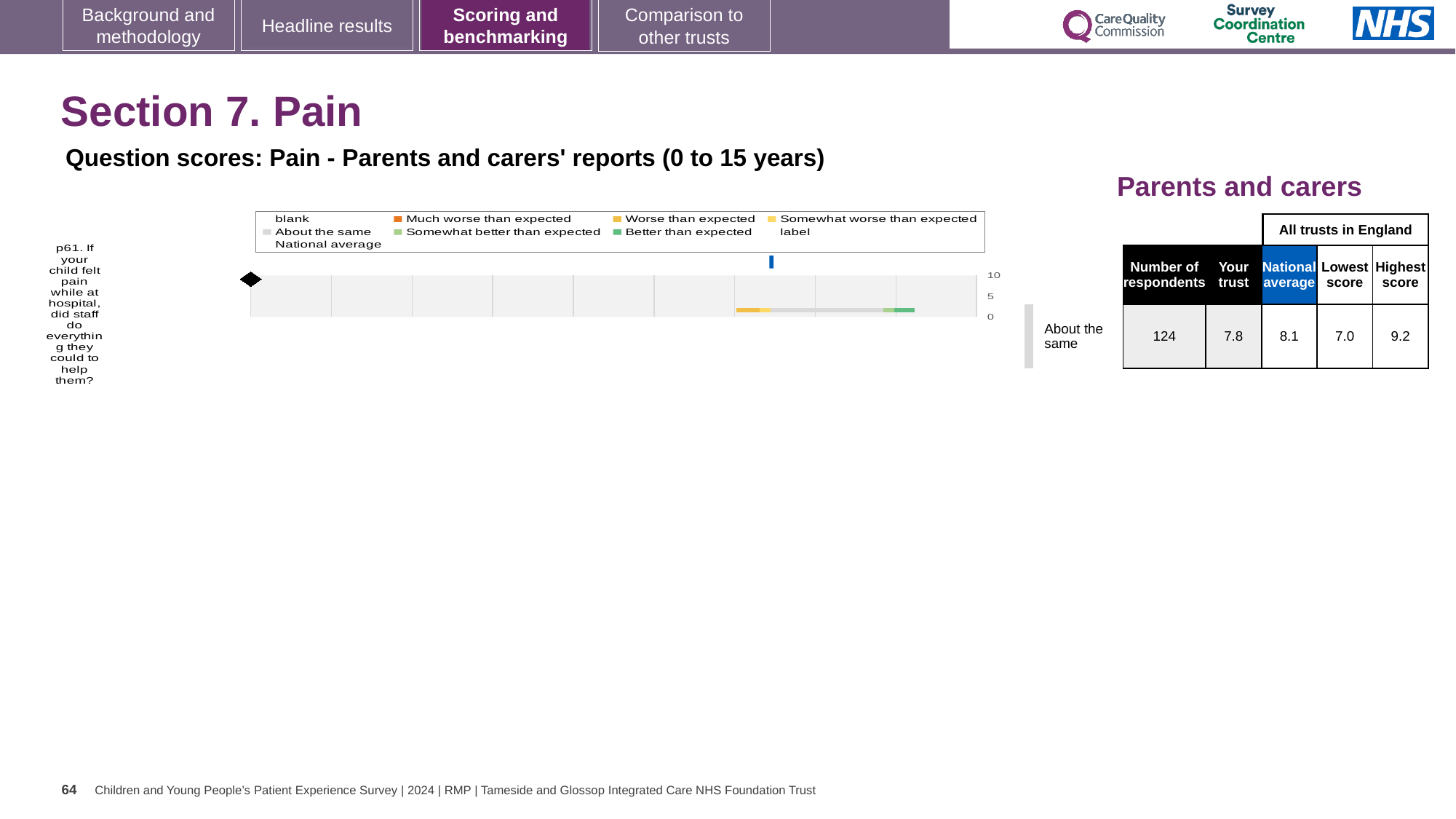
Which question number is plotted in the chart? p61 Which is larger for the p61 question: the 'Your trust' score or the national average? National average What kind of chart is shown on the slide? bar chart In the table next to the chart, what is the national average score for the p61 question? 8.1 In the table next to the chart, what is the number of respondents for the p61 question? 124 What benchmarking category is the p61 question assigned to, as labelled beside the table? About the same How many survey questions are plotted in the chart? 1 In the table next to the chart, what is the highest score among all trusts in England for the p61 question? 9.2 In the table next to the chart, what is the lowest score among all trusts in England for the p61 question? 7.0 In the table next to the chart, what is the 'Your trust' score for the p61 question? 7.8 What is the highest tick value shown on the chart's score axis? 10 What is the difference between the highest score and the lowest score shown in the table for the p61 question? 2.2